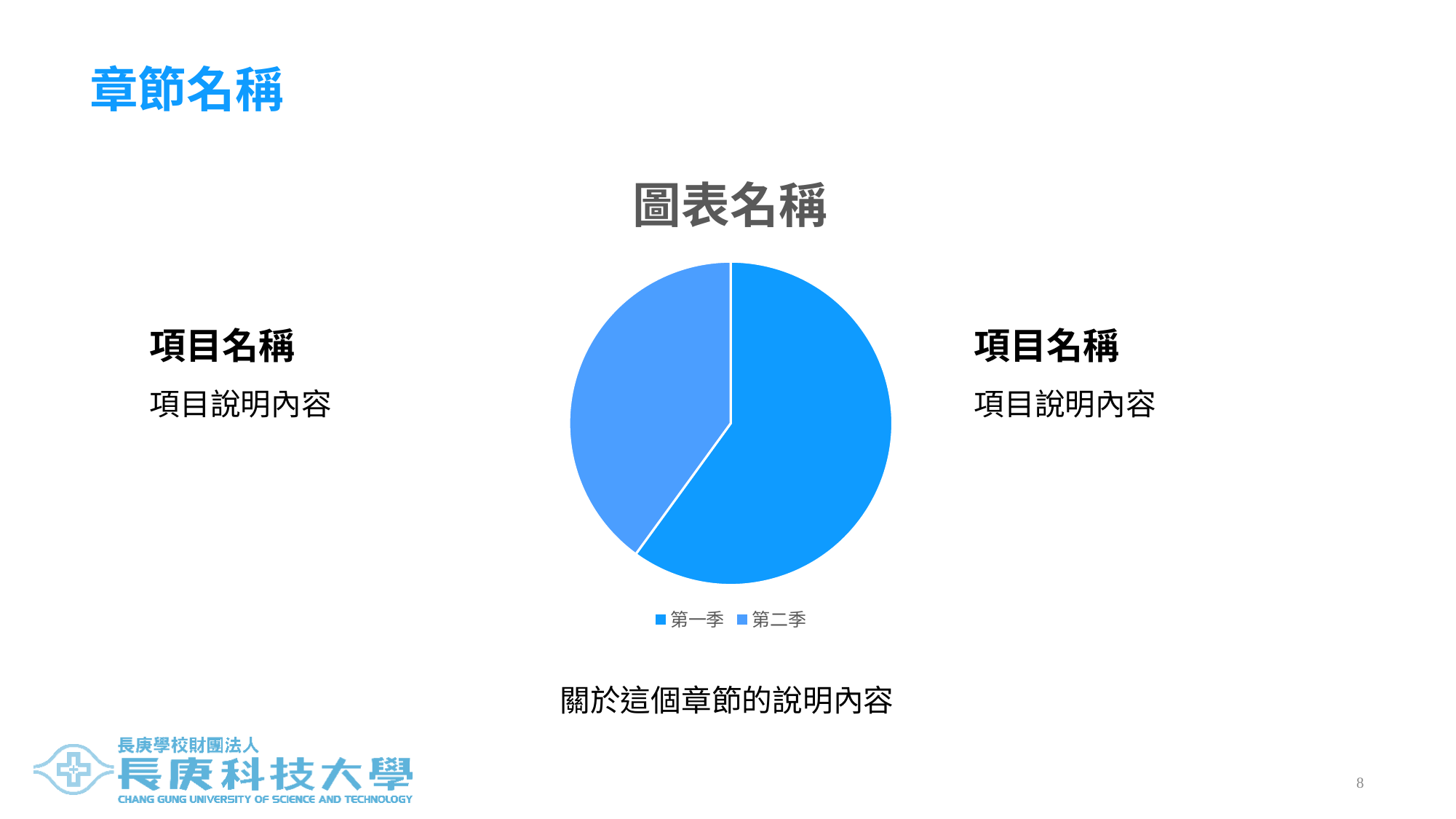
What are the two categories listed in the chart legend? 第一季 and 第二季 Which category has the largest slice of the pie? 第一季 Which slice is larger, 第一季 or 第二季? 第一季 How many entries does the chart legend list? 2 Does the 第一季 slice take up more or less than half of the pie? more Does the 第二季 slice take up more or less than half of the pie? less How many slices does the pie chart have? 2 What kind of chart is shown on the slide? pie chart Which category has the smallest slice of the pie? 第二季 What is the title of the chart? 圖表名稱